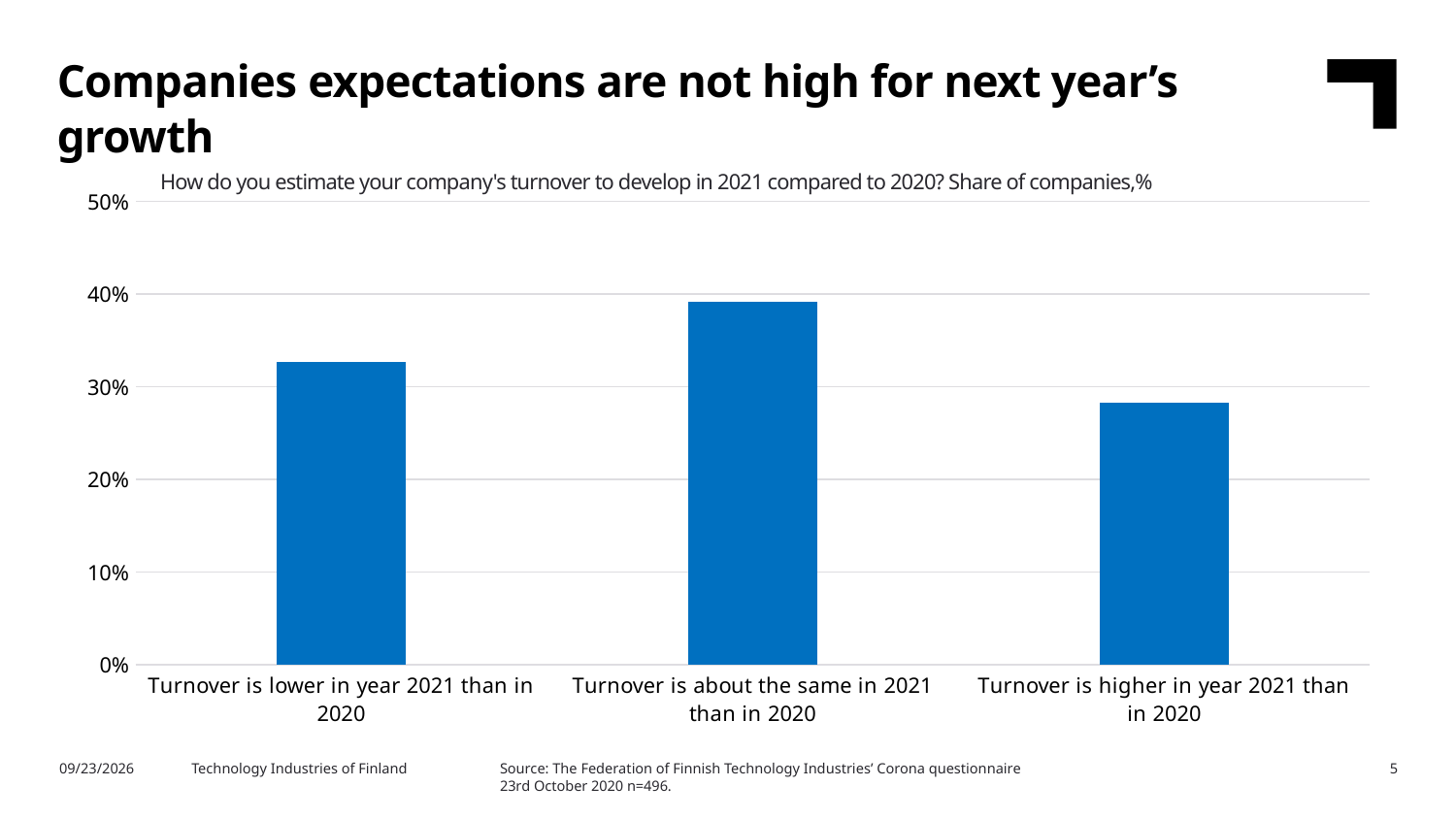
Is the value for 'Turnover is higher in year 2021 than in 2020' greater or less than 30%? less Is the value for 'Turnover is lower in year 2021 than in 2020' greater or less than 30%? greater What kind of chart is shown on the slide? Bar chart Which category has the lowest share of companies? Turnover is higher in year 2021 than in 2020 Is the value for 'Turnover is higher in year 2021 than in 2020' greater or less than 20%? greater What is the highest value shown on the vertical axis of the chart? 50% How many categories are shown in the chart? 3 Which category has the highest share of companies? Turnover is about the same in 2021 than in 2020 Which is larger: the share for 'Turnover is about the same in 2021 than in 2020' or for 'Turnover is lower in year 2021 than in 2020'? Turnover is about the same in 2021 than in 2020 What is the title of the chart? How do you estimate your company's turnover to develop in 2021 compared to 2020? Share of companies,% Which is larger: the share for 'Turnover is lower in year 2021 than in 2020' or for 'Turnover is higher in year 2021 than in 2020'? Turnover is lower in year 2021 than in 2020